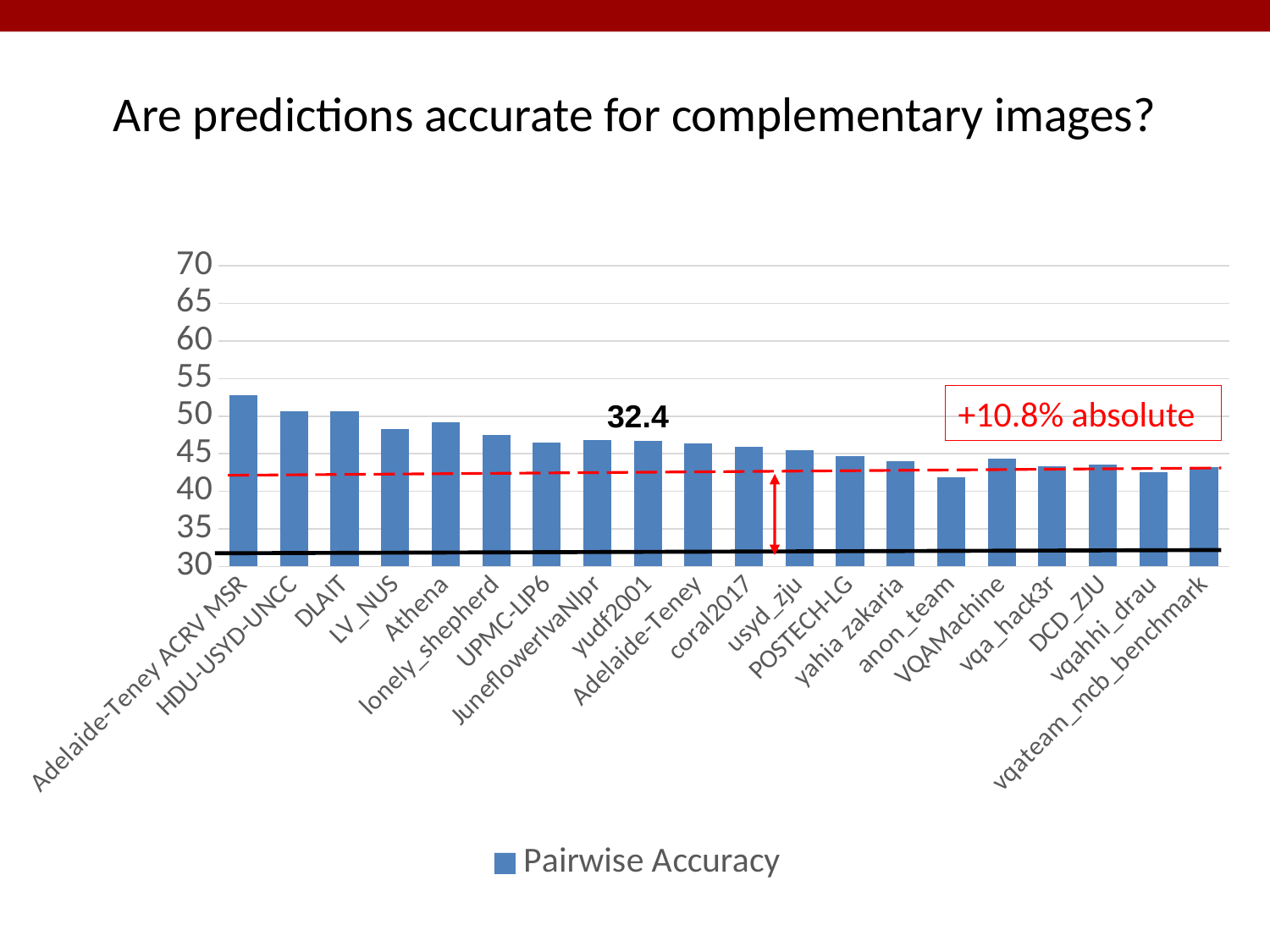
How many series does the legend list? 1 Which has a higher Pairwise Accuracy, DLAIT or vqahhi_drau? DLAIT What kind of chart is shown on the slide? bar chart Which team has the highest Pairwise Accuracy? Adelaide-Teney ACRV MSR Do the Pairwise Accuracy values generally rise or fall from left to right along the x axis? fall Which team has the lowest Pairwise Accuracy? anon_team What is the name of the series shown in the legend? Pairwise Accuracy What value is labelled on the black horizontal baseline in the chart? 32.4 Is the Pairwise Accuracy for Adelaide-Teney ACRV MSR greater or less than 50? greater Is the Pairwise Accuracy for LV_NUS greater or less than 50? less How many teams (categories) are plotted on the x axis? 20 Is the Pairwise Accuracy for anon_team greater or less than 45? less